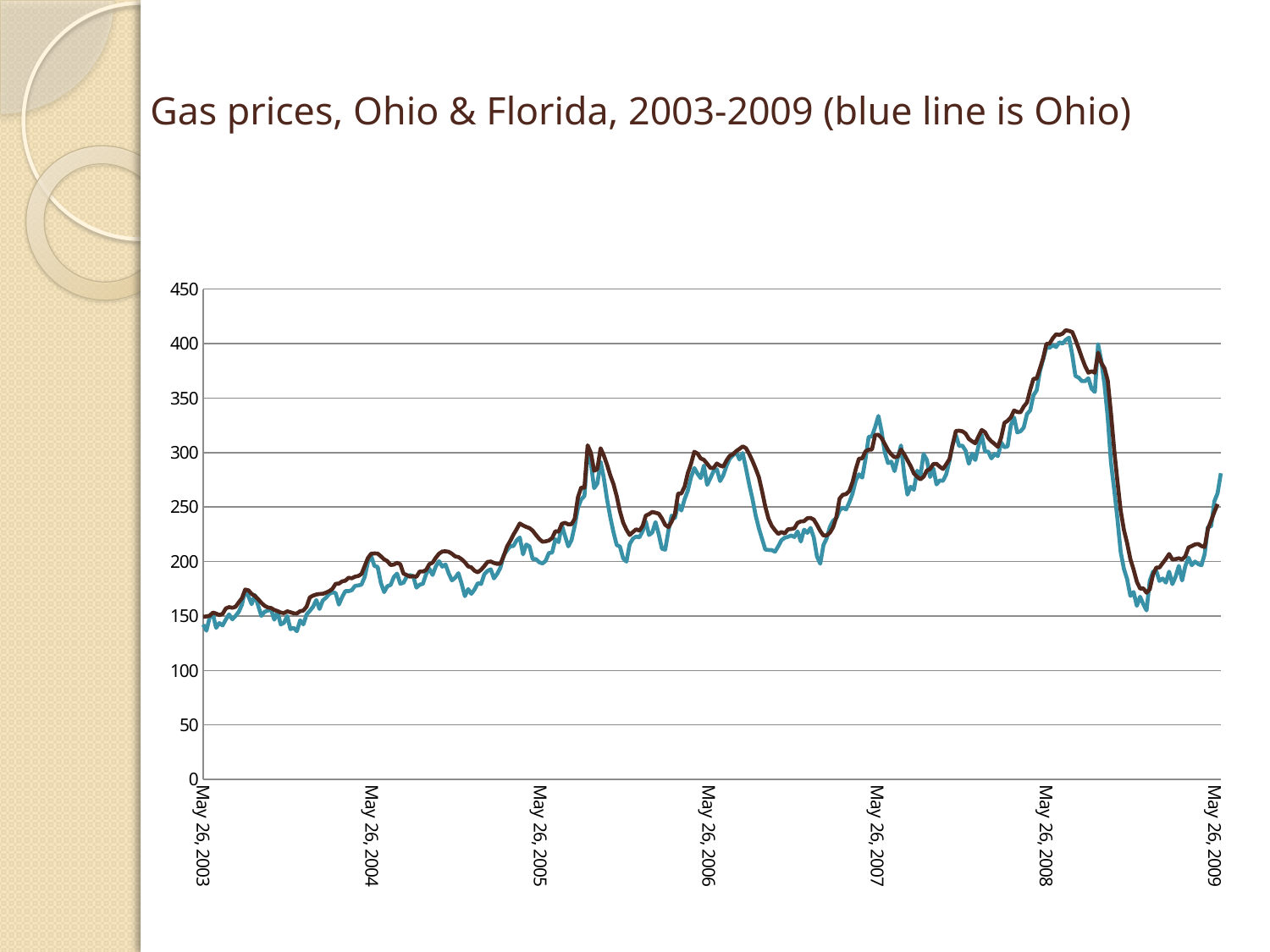
Do gas prices generally rise or fall from May 26, 2003 to May 26, 2008? rise How many date labels are shown on the x axis? 7 Is the lowest value of the Ohio line in early 2009 greater or less than 200? less What kind of chart is shown on the slide? line chart At which x-axis date label do both lines reach their highest values? May 26, 2008 What is the title of the chart on the slide? Gas prices, Ohio & Florida, 2003-2009 (blue line is Ohio) Is the highest value reached by the Florida line greater or less than 400? greater At which x-axis date label are both lines at their lowest values? May 26, 2003 Is the value for Ohio at May 26, 2003 greater or less than 150? less Which state does the blue line represent? Ohio How many series are plotted on the chart? 2